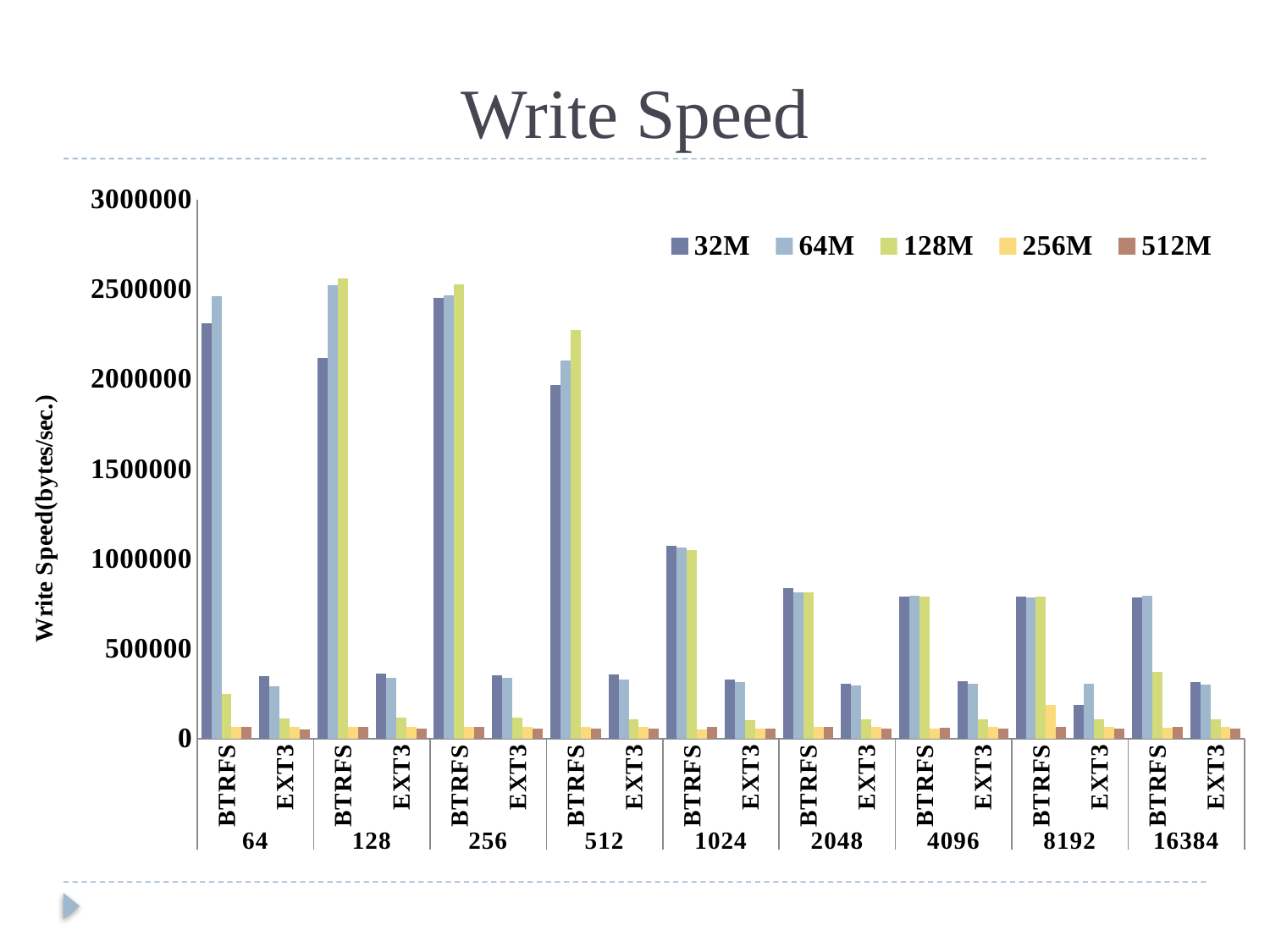
Which series is shown in the darkest blue colour in the legend? 32M Is the 32M value for BTRFS in the 2048 group greater or less than 1000000? less Is the 32M value for EXT3 in the 64 group greater or less than 500000? less Is the 64M value for BTRFS in the 64 group greater or less than 2000000? greater In the 64 group, which has the larger 64M value, BTRFS or EXT3? BTRFS How many series does the legend list? 5 Which BTRFS group has the highest 256M value? 8192 How many file-size groups are shown along the x axis? 9 What kind of chart is shown on the slide? bar chart What is the label of the y axis? Write Speed(bytes/sec.) For the 128M series, which BTRFS bar is larger, the one in the 64 group or the one in the 128 group? 128 group